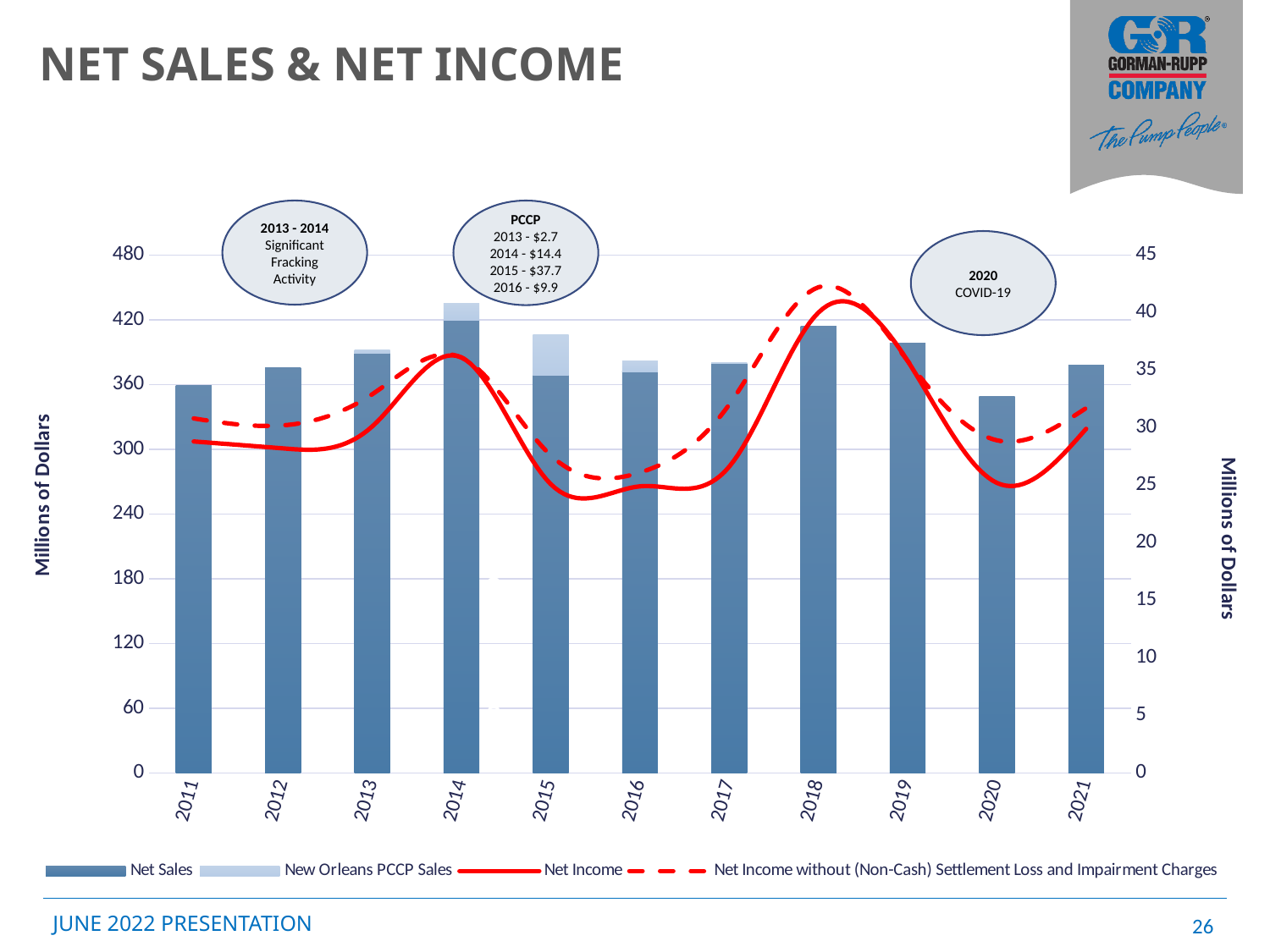
Which year has the lowest Net Sales bar? 2020 Which year has the larger Net Sales bar, 2012 or 2020? 2012 Which year has the tallest bar (Net Sales plus New Orleans PCCP Sales)? 2014 In which year does the Net Income line reach its highest point? 2018 Is the Net Sales value for 2020 greater or less than 360? less According to the PCCP annotation, what were the New Orleans PCCP sales in 2015? $37.7 What kind of chart is this? Combined bar and line chart Is the Net Sales value for 2012 greater or less than 360? greater What is the title of the chart? NET SALES & NET INCOME Is the Net Income without (Non-Cash) Settlement Loss and Impairment Charges value for 2018 greater or less than 40? greater How many years are shown on the x axis? 11 How many series does the legend list? 4